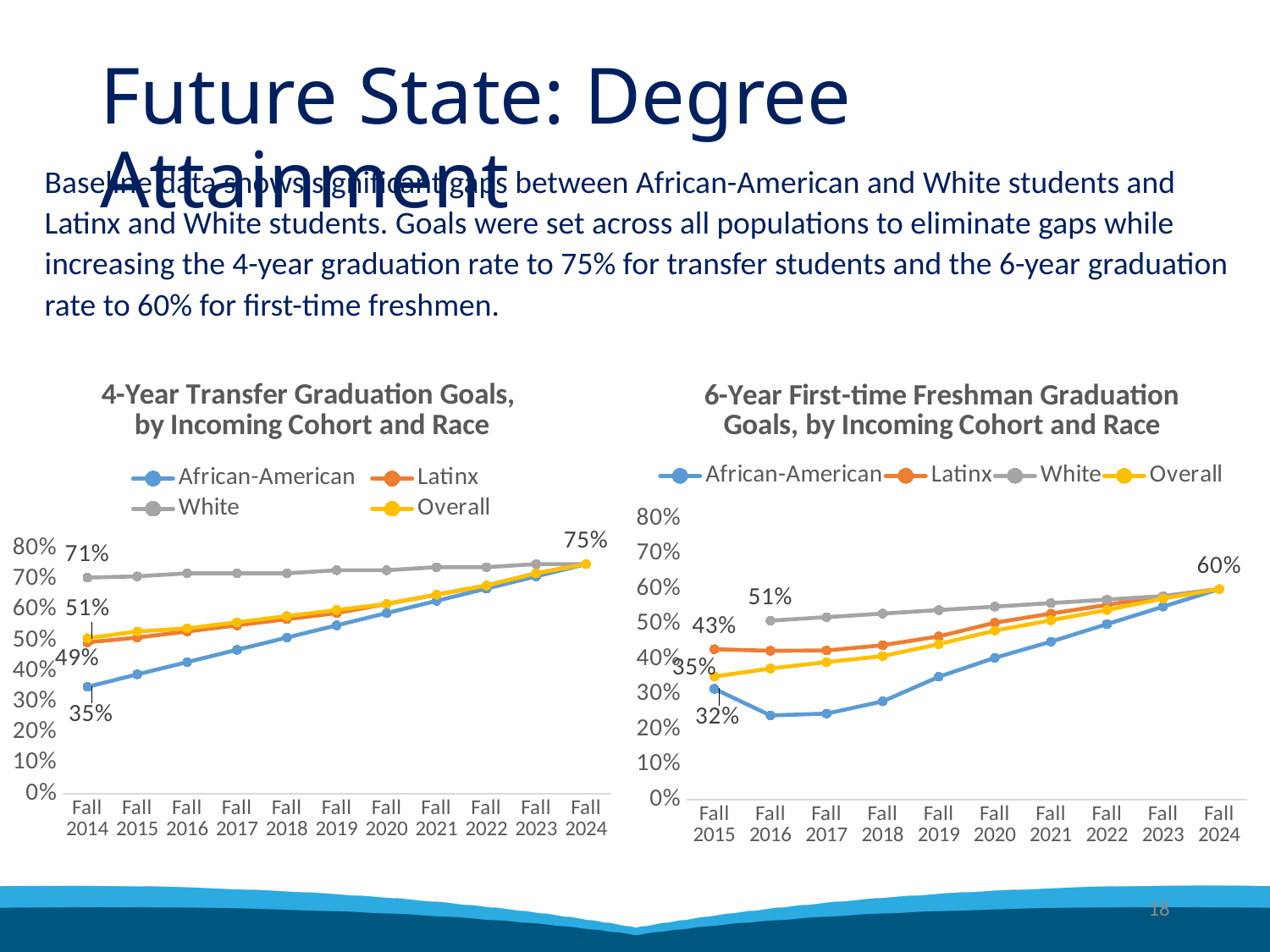
In the 4-Year Transfer Graduation Goals chart, what is the difference between the White and African-American values in Fall 2014? 36 percentage points In the 6-Year First-time Freshman Graduation Goals chart, what is the value for African-American students in Fall 2015? 32% What type of chart is the 4-Year Transfer Graduation Goals chart? line chart In the 4-Year Transfer Graduation Goals chart, what is the value for White students in Fall 2014? 71% In the 6-Year First-time Freshman Graduation Goals chart, which group has the lowest value in Fall 2015? African-American In the 4-Year Transfer Graduation Goals chart, what value do all groups reach in Fall 2024? 75% In the 4-Year Transfer Graduation Goals chart, what is the value for African-American students in Fall 2014? 35% In the 6-Year First-time Freshman Graduation Goals chart, what value do all groups reach in Fall 2024? 60% How many incoming cohorts are shown on the x axis of the 4-Year Transfer Graduation Goals chart? 11 In the 6-Year First-time Freshman Graduation Goals chart, is the African-American value for Fall 2016 greater or less than 30%? less How many series does the legend of the 6-Year First-time Freshman Graduation Goals chart list? 4